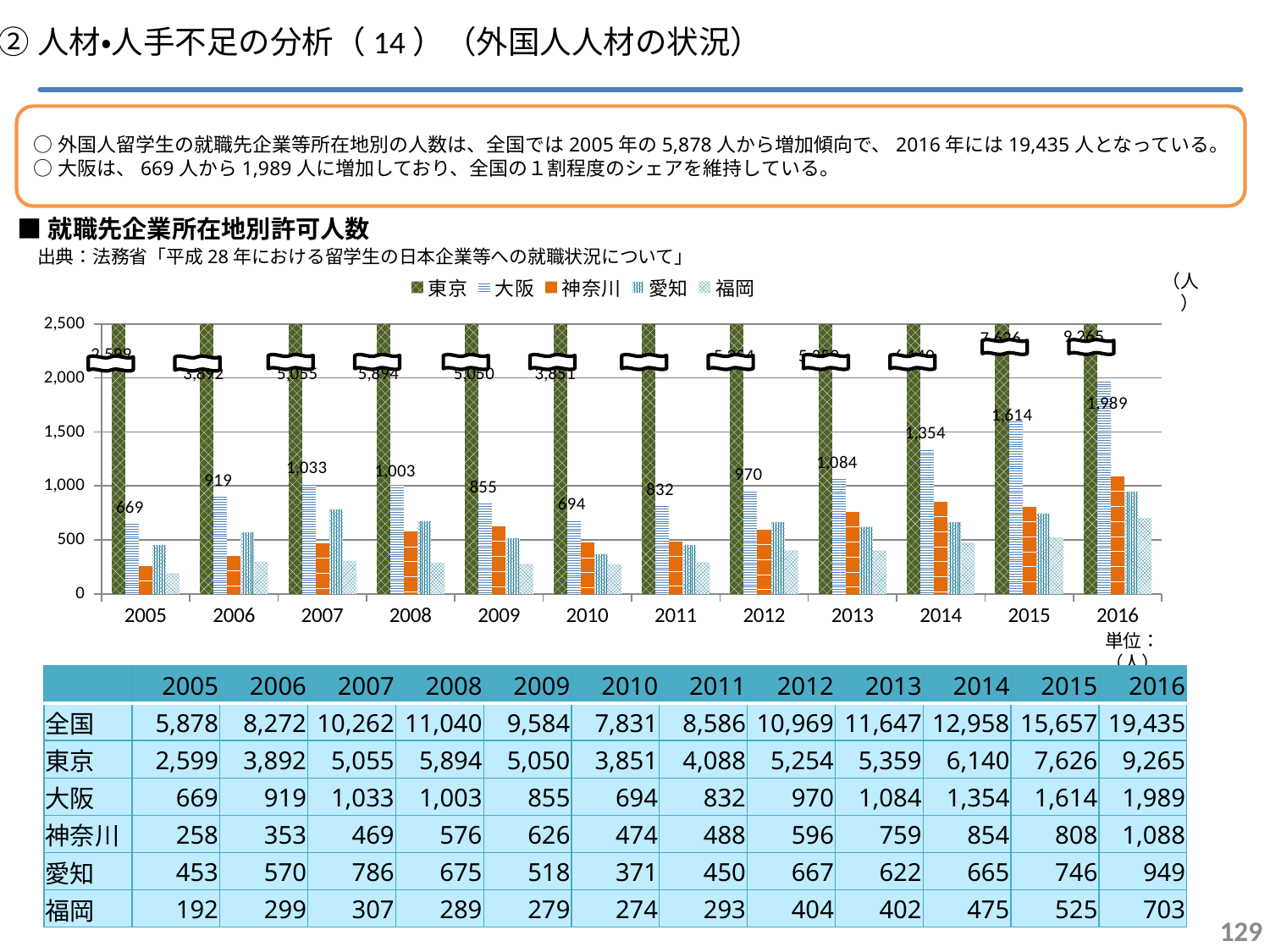
Which series in the chart is drawn in orange? 神奈川 In which year is the 大阪 value highest on the chart? 2016 What kind of chart is shown on the slide? bar chart Is the value for 大阪 in 2014 greater or less than 1,000? greater What is the difference between the 大阪 values for 2016 and 2005? 1,320 Which is larger on the chart, the 大阪 value for 2007 or for 2008? 2007 What is the value for 大阪 in 2010 on the chart? 694 What is the value for 大阪 in 2016 on the chart? 1,989 What is the value for 大阪 in 2005 on the chart? 669 How many series does the chart legend list? 5 In which year is the 大阪 value lowest on the chart? 2005 How many years are shown along the x axis of the chart? 12